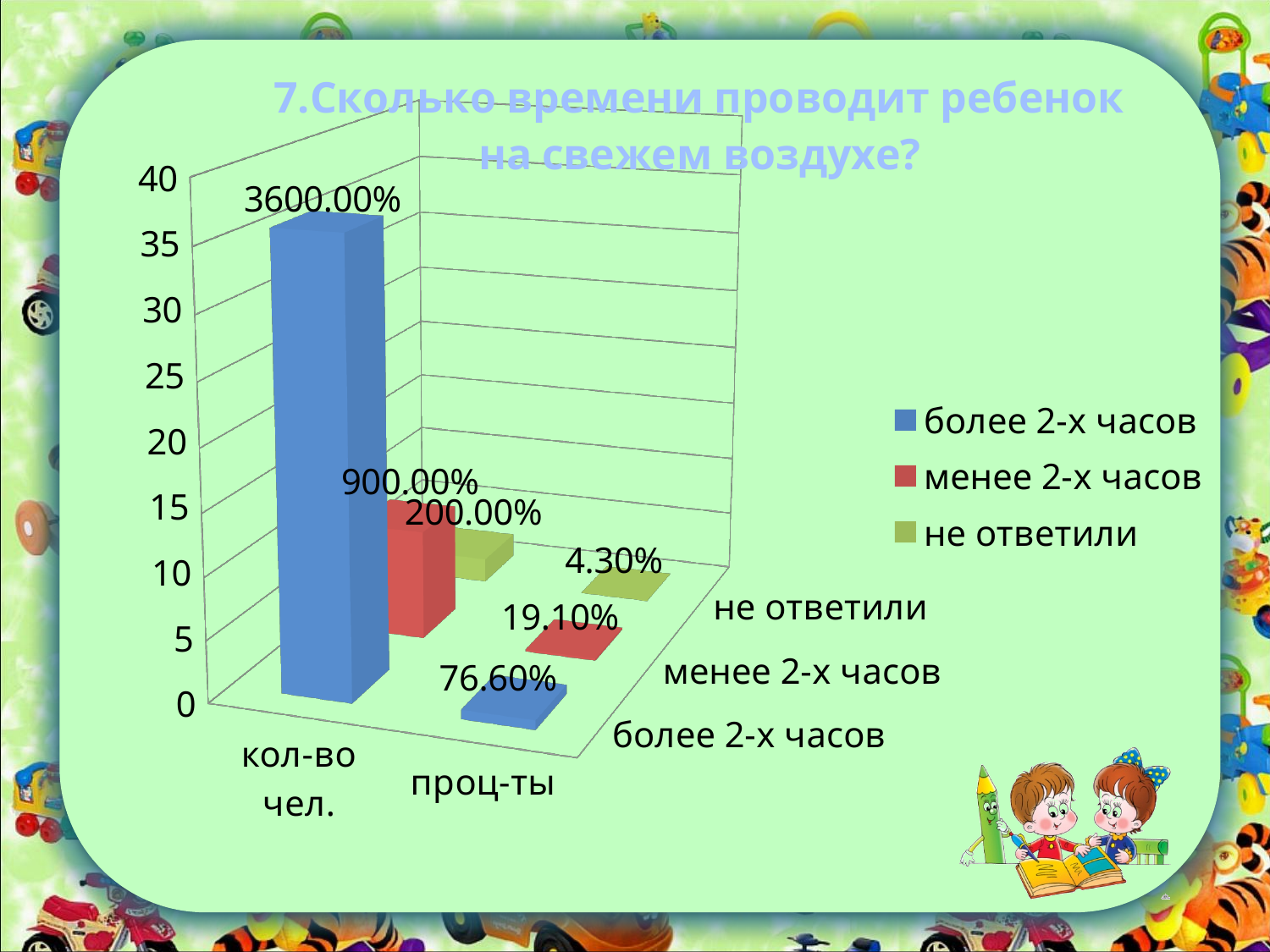
Which is larger in the 'проц-ты' category: 'менее 2-х часов' or 'не ответили'? менее 2-х часов How many series does the legend list? 3 What is the data label on the 'менее 2-х часов' bar for the 'проц-ты' category? 19.10% What is the data label on the 'более 2-х часов' bar for the 'проц-ты' category? 76.60% What kind of chart is shown on the slide? bar chart What is the data label on the 'более 2-х часов' bar for the 'кол-во чел.' category? 3600.00% What is the data label on the 'не ответили' bar for the 'проц-ты' category? 4.30% What is the data label on the 'не ответили' bar for the 'кол-во чел.' category? 200.00% Which series has the smallest value in the 'проц-ты' category? не ответили What colour is the 'менее 2-х часов' series in the legend? red Which series has the tallest bar in the 'кол-во чел.' category? более 2-х часов What is the data label on the 'менее 2-х часов' bar for the 'кол-во чел.' category? 900.00%